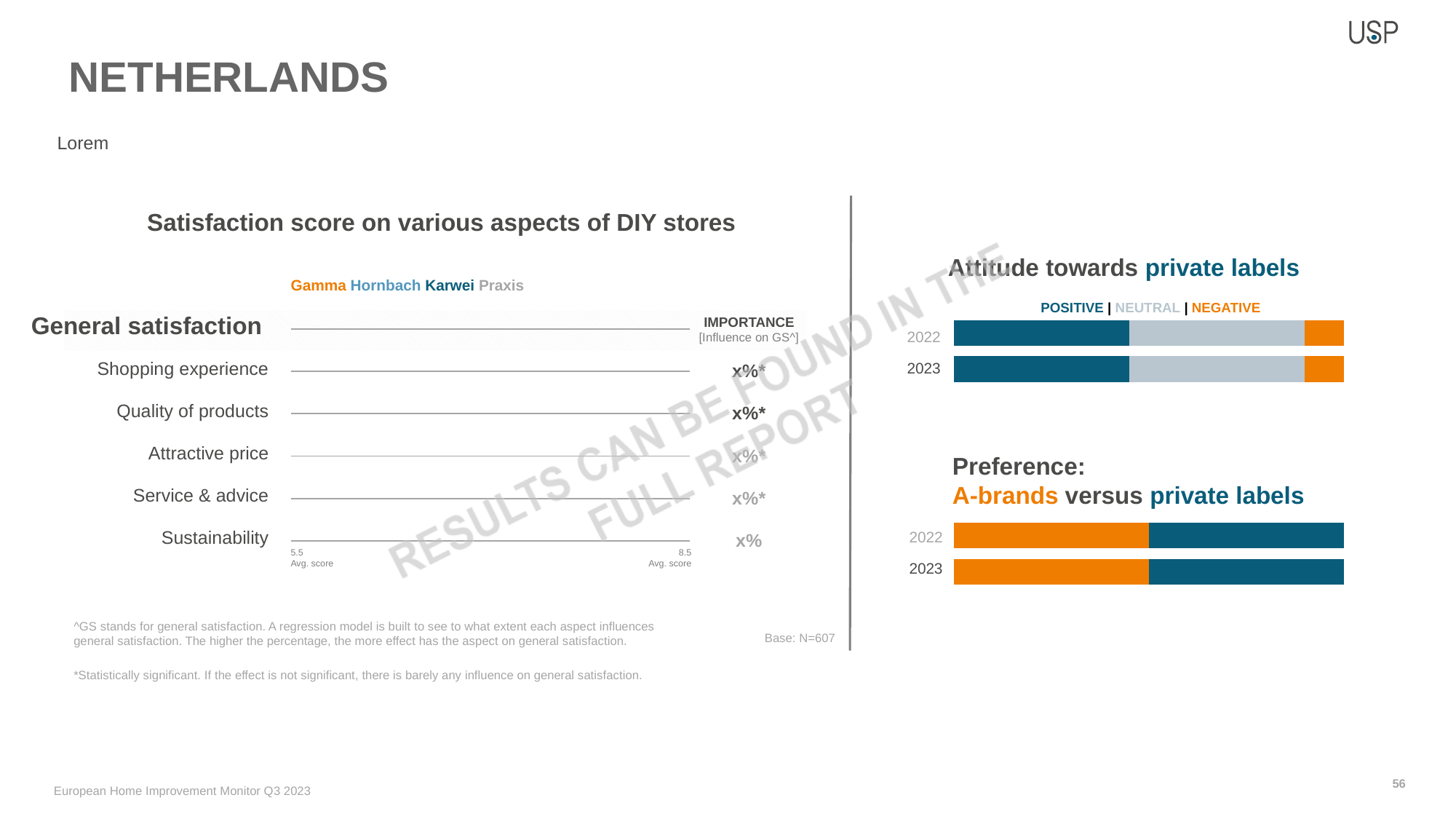
What colour represents the negative attitude in the 'Attitude towards private labels' chart? Orange In the 'Attitude towards private labels' chart, which is larger for 2023: the neutral segment or the negative segment? Neutral How many aspects (excluding general satisfaction) are listed in the 'Satisfaction score on various aspects of DIY stores' chart? 5 What is the base sample size shown for the 'Satisfaction score on various aspects of DIY stores' chart? N=607 In the 'Attitude towards private labels' chart, which attitude segment is the smallest for 2023? Negative How many store brands are listed in the legend of the 'Satisfaction score on various aspects of DIY stores' chart? 4 How many years are shown in the 'Attitude towards private labels' chart? 2 In the 'Attitude towards private labels' chart, which is larger for 2022: the positive segment or the negative segment? Positive What kind of chart is the 'Preference: A-brands versus private labels' chart? bar chart How many series does the legend of the 'Attitude towards private labels' chart list? 3 How many years are shown in the 'Preference: A-brands versus private labels' chart? 2 What kind of chart is the 'Attitude towards private labels' chart? bar chart